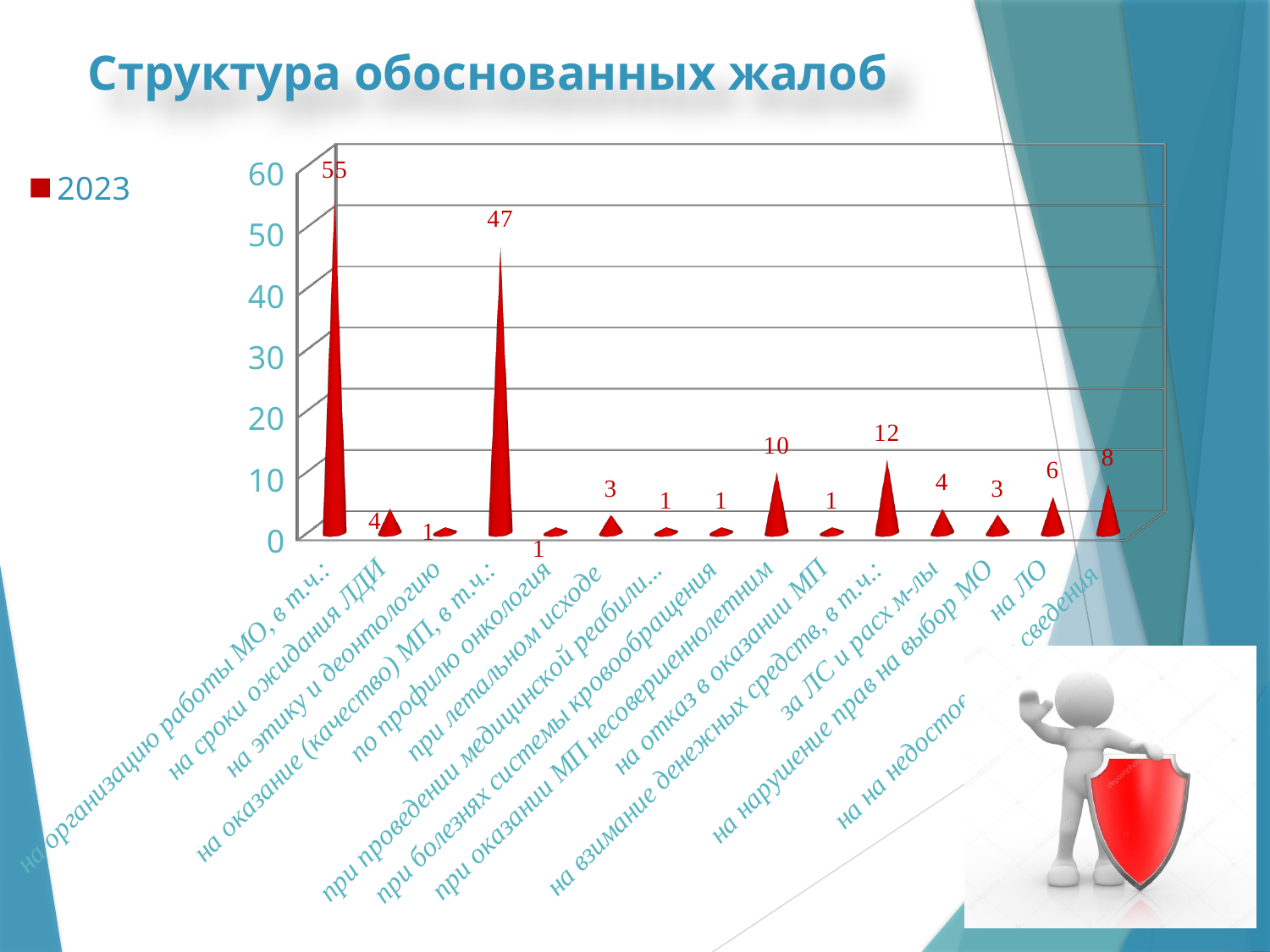
What is the value for 'на ЛО'? 6 What is the title of the slide's chart? Структура обоснованных жалоб How many categories are shown on the x axis? 15 What is the value for 'на организацию работы МО, в т.ч.:'? 55 What is the difference between the values for 'на организацию работы МО, в т.ч.:' and 'на оказание (качество) МП, в т.ч.:'? 8 What is the value for 'на оказание (качество) МП, в т.ч.:'? 47 What is the value for 'на взимание денежных средств, в т.ч.:'? 12 What is the value for 'при оказании МП несовершеннолетним'? 10 How many series does the legend list? 1 Is the value for 'на оказание (качество) МП, в т.ч.:' greater or less than 40? greater Which is larger: the value for 'на взимание денежных средств, в т.ч.:' or for 'при оказании МП несовершеннолетним'? на взимание денежных средств, в т.ч.: Which category has the highest value? на организацию работы МО, в т.ч.: